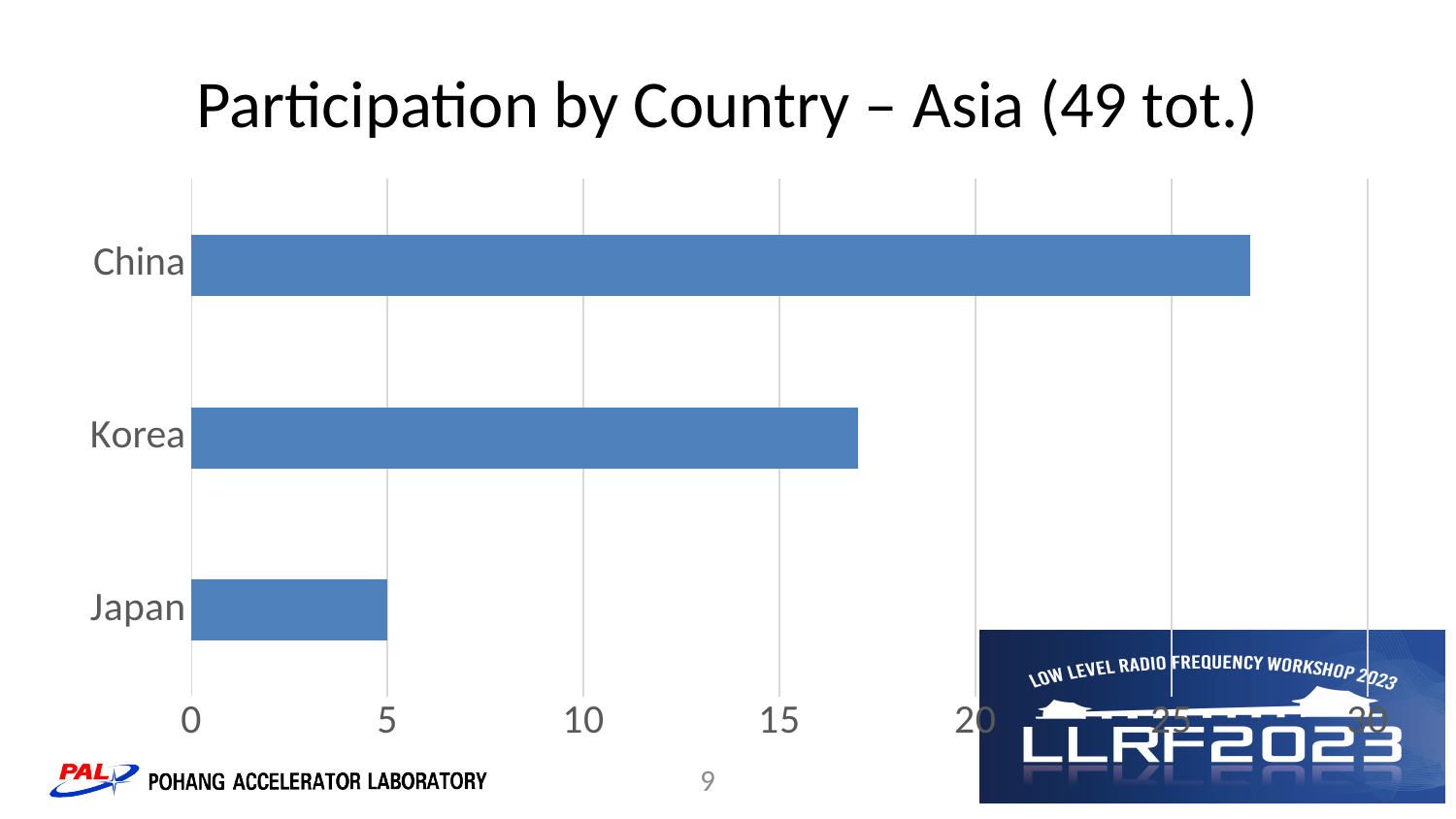
Which country has the highest participation? China Is the value for Korea greater or less than 15? greater What kind of chart is shown on the slide? bar chart Is the value for Korea greater or less than 20? less What is the title of the chart? Participation by Country – Asia (49 tot.) How many countries are shown in the chart? 3 Is the value for Japan greater or less than 10? less Which country has the lowest participation? Japan Which has a larger value, China or Korea? China What is the value for Japan? 5 What is the highest value shown on the x axis? 30